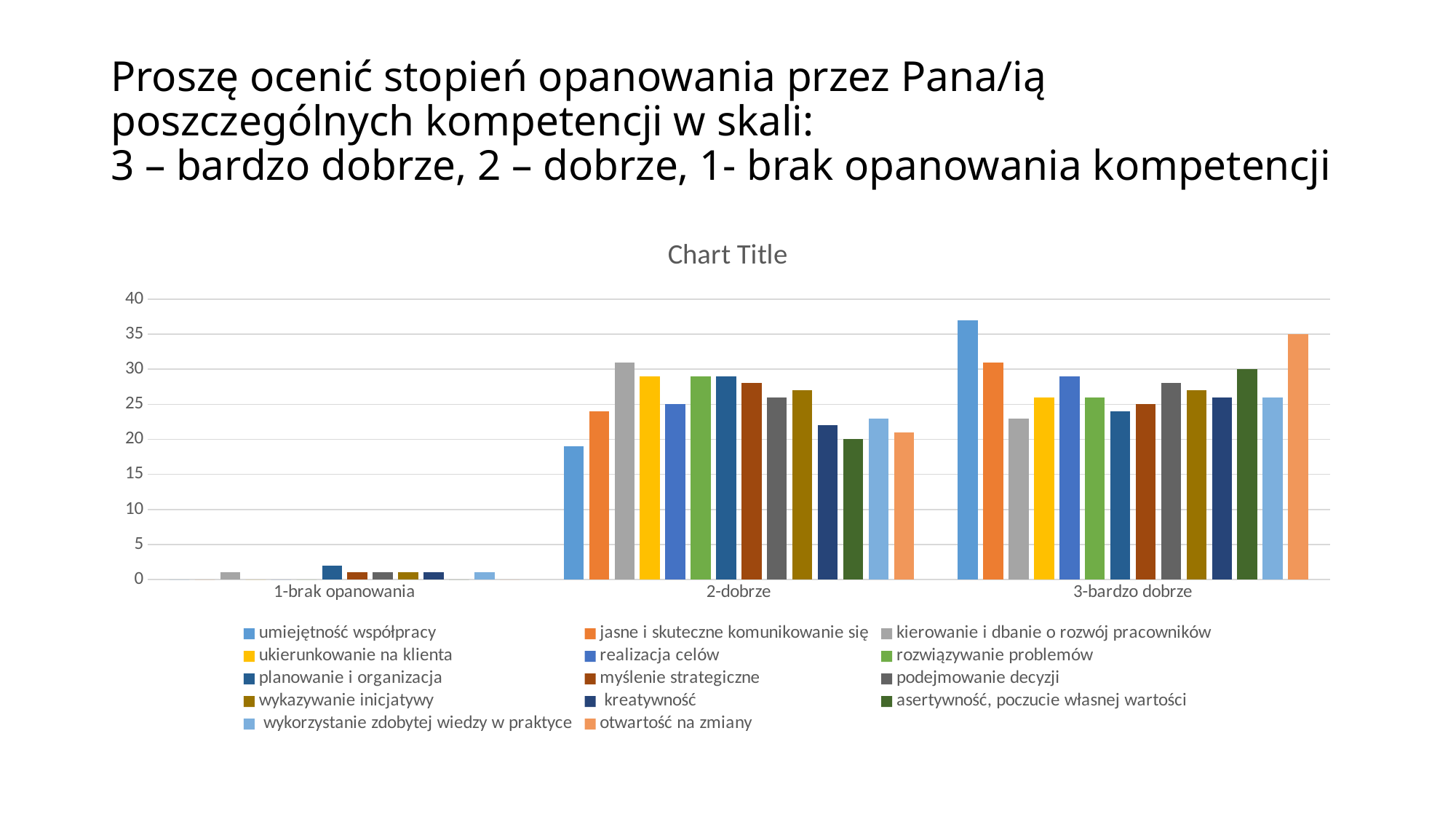
Is the value for umiejętność współpracy in the 2-dobrze category greater or less than 25? less How many series does the chart legend list? 14 Do the values for umiejętność współpracy rise or fall from 1-brak opanowania to 3-bardzo dobrze? rise How many categories are shown on the x axis of the chart? 3 What is the title shown above the chart? Chart Title For umiejętność współpracy, which category has the larger value: 2-dobrze or 3-bardzo dobrze? 3-bardzo dobrze For kierowanie i dbanie o rozwój pracowników, which category has the larger value: 2-dobrze or 3-bardzo dobrze? 2-dobrze Is the value for asertywność, poczucie własnej wartości in the 2-dobrze category greater or less than 25? less Is the value for umiejętność współpracy in the 3-bardzo dobrze category greater or less than 30? greater Which series has the highest bar in the 2-dobrze category? kierowanie i dbanie o rozwój pracowników What kind of chart is shown on the slide? bar chart